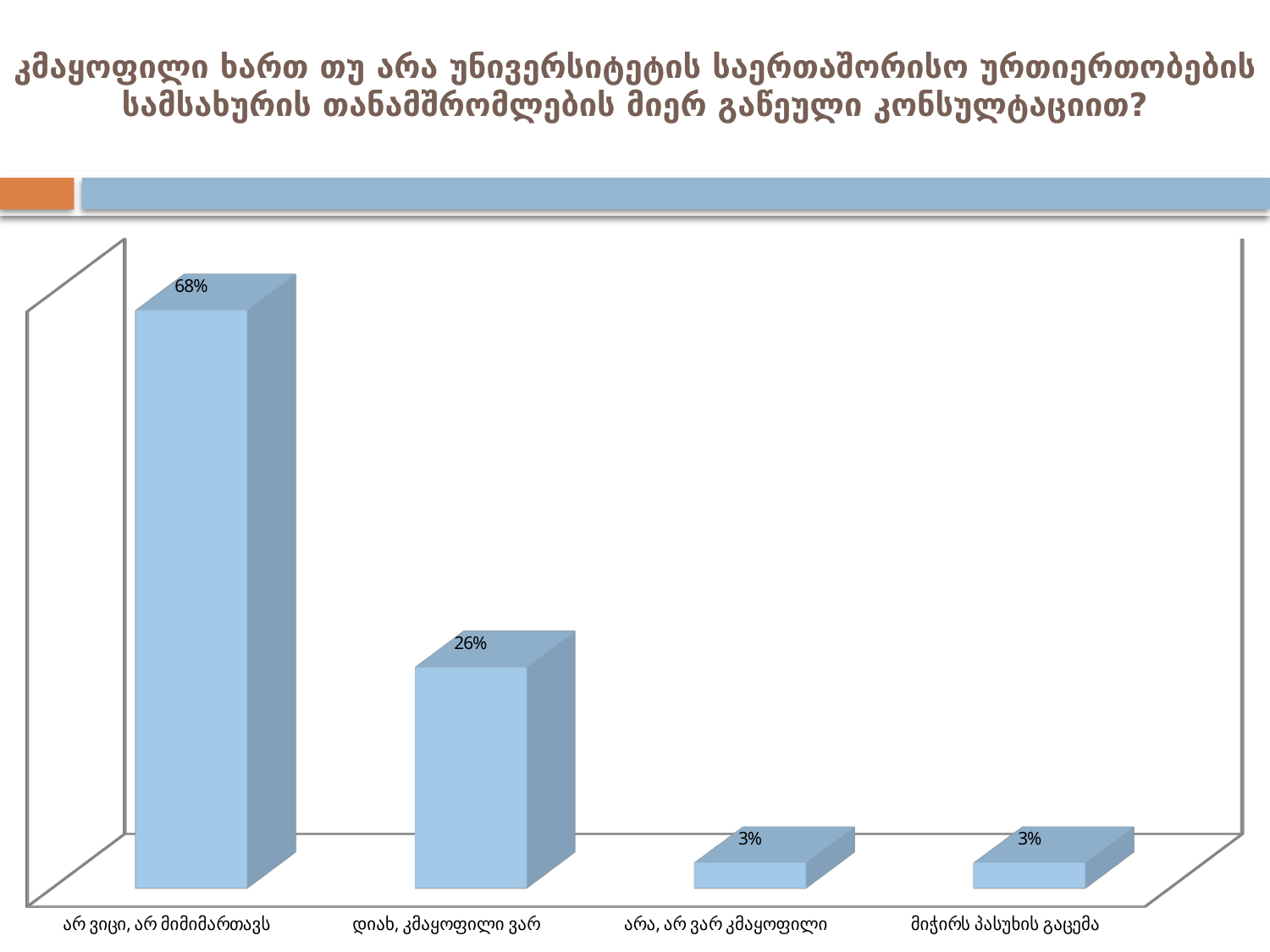
Do the values rise or fall from left to right across the categories? fall Which category has the highest value? არ ვიცი, არ მიმიმართავს What is the value for "მიჭირს პასუხის გაცემა"? 3% How many categories are shown in the chart? 4 What is the difference between the values for "არ ვიცი, არ მიმიმართავს" and "დიახ, კმაყოფილი ვარ"? 42% How many categories have a value of 3%? 2 What is the difference between the values for "დიახ, კმაყოფილი ვარ" and "არა, არ ვარ კმაყოფილი"? 23% Which is larger, the value for "დიახ, კმაყოფილი ვარ" or the value for "მიჭირს პასუხის გაცემა"? დიახ, კმაყოფილი ვარ What is the value for "დიახ, კმაყოფილი ვარ"? 26% What type of chart is shown on the slide? bar chart What is the value for "არ ვიცი, არ მიმიმართავს"? 68% What is the value for "არა, არ ვარ კმაყოფილი"? 3%